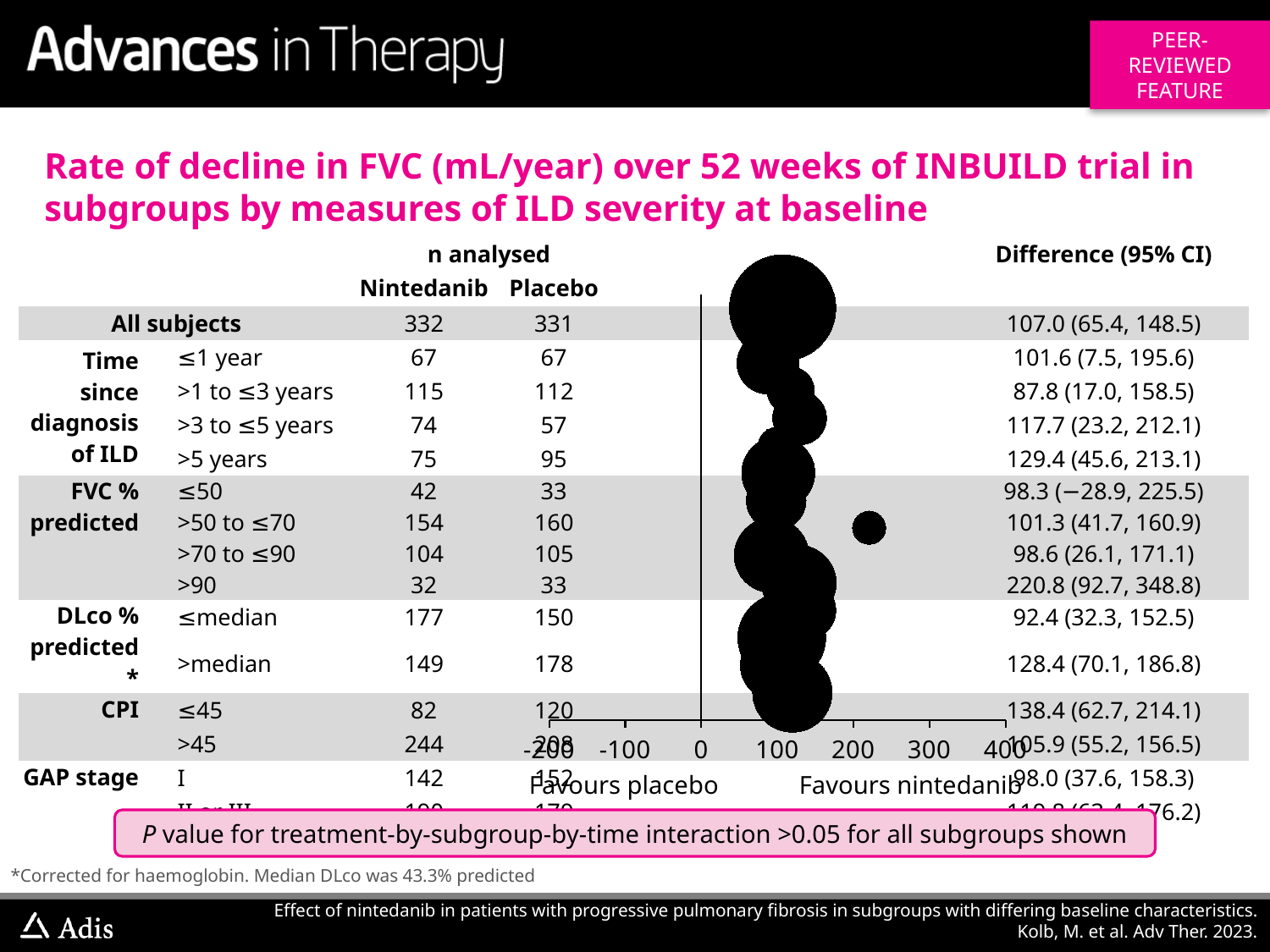
What is the difference between the point estimates for DLco % predicted >median and ≤median? 36.0 What is the difference between the point estimates for FVC % predicted >90 and FVC % predicted ≤50? 122.5 How many FVC % predicted subgroups are shown? 4 How many patients were analysed in the nintedanib arm for all subjects? 332 What kind of chart is shown on the slide? Forest plot What is the difference (95% CI) for the FVC % predicted >90 subgroup? 220.8 (92.7, 348.8) Is the point-estimate difference for all subjects greater or less than 100? greater Within the FVC % predicted subgroups, which has the smallest point-estimate difference? ≤50 Which subgroup shown has the largest point-estimate difference? FVC % predicted >90 Which has the larger point-estimate difference: time since diagnosis >5 years or ≤1 year? >5 years What does the right side of the x axis favour, according to the axis label? Favours nintedanib What is the difference (95% CI) in rate of FVC decline for all subjects? 107.0 (65.4, 148.5)